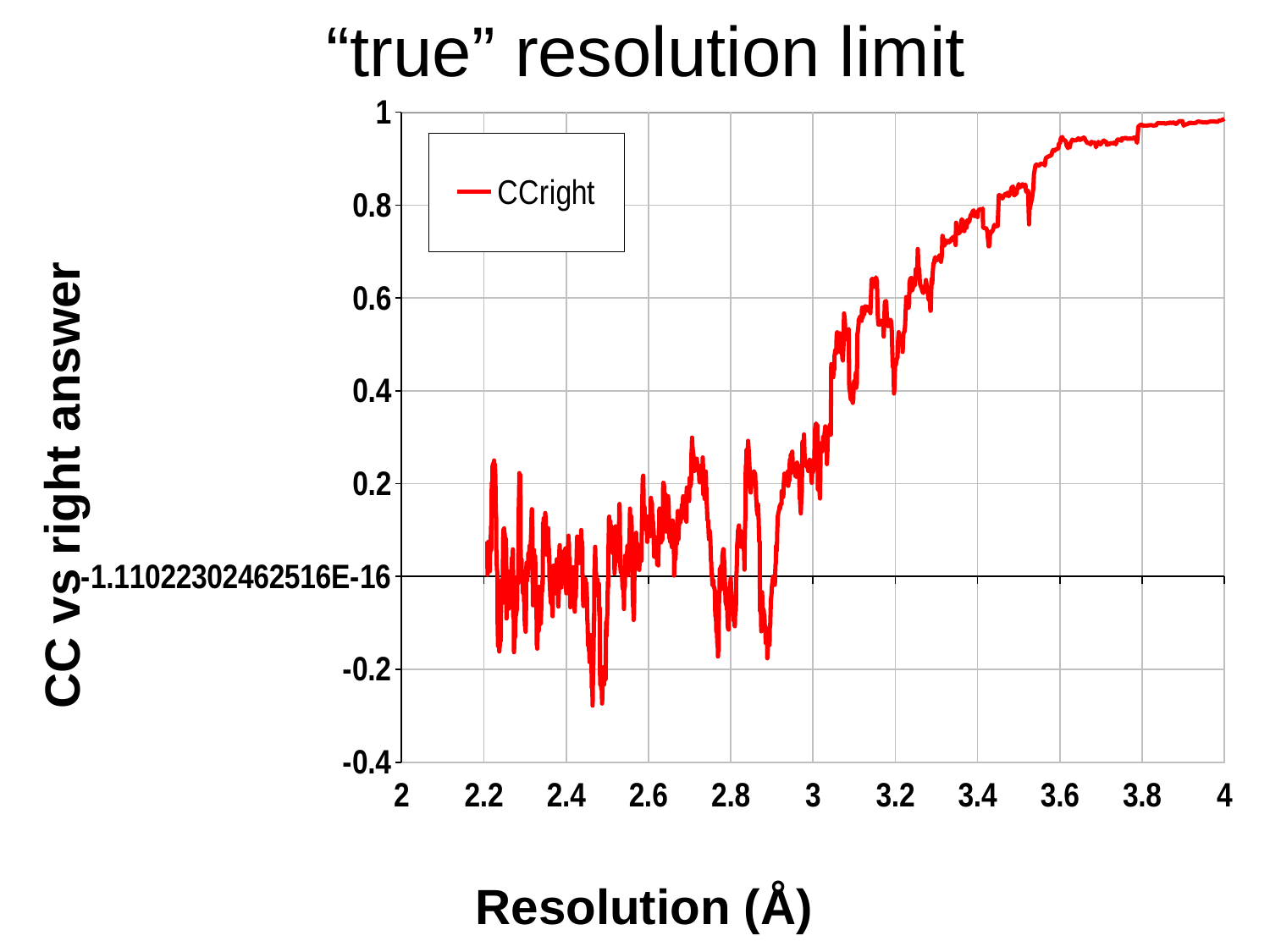
Is the CCright value at a resolution of 2.4 Å greater or less than 0.2? less Is the CCright value at a resolution of 3.4 Å greater or less than 0.6? greater How many series does the legend list? 1 Is the CCright value at a resolution of 2.8 Å greater or less than 0.2? less What is the name of the series shown in the legend? CCright Is the CCright value higher at a resolution of 3.8 Å or at 2.6 Å? 3.8 Å What is the title of the chart? "true" resolution limit Overall, does the CCright value rise or fall as resolution increases from 2.2 to 4 Å? Rise What kind of chart is shown on the slide? Line chart